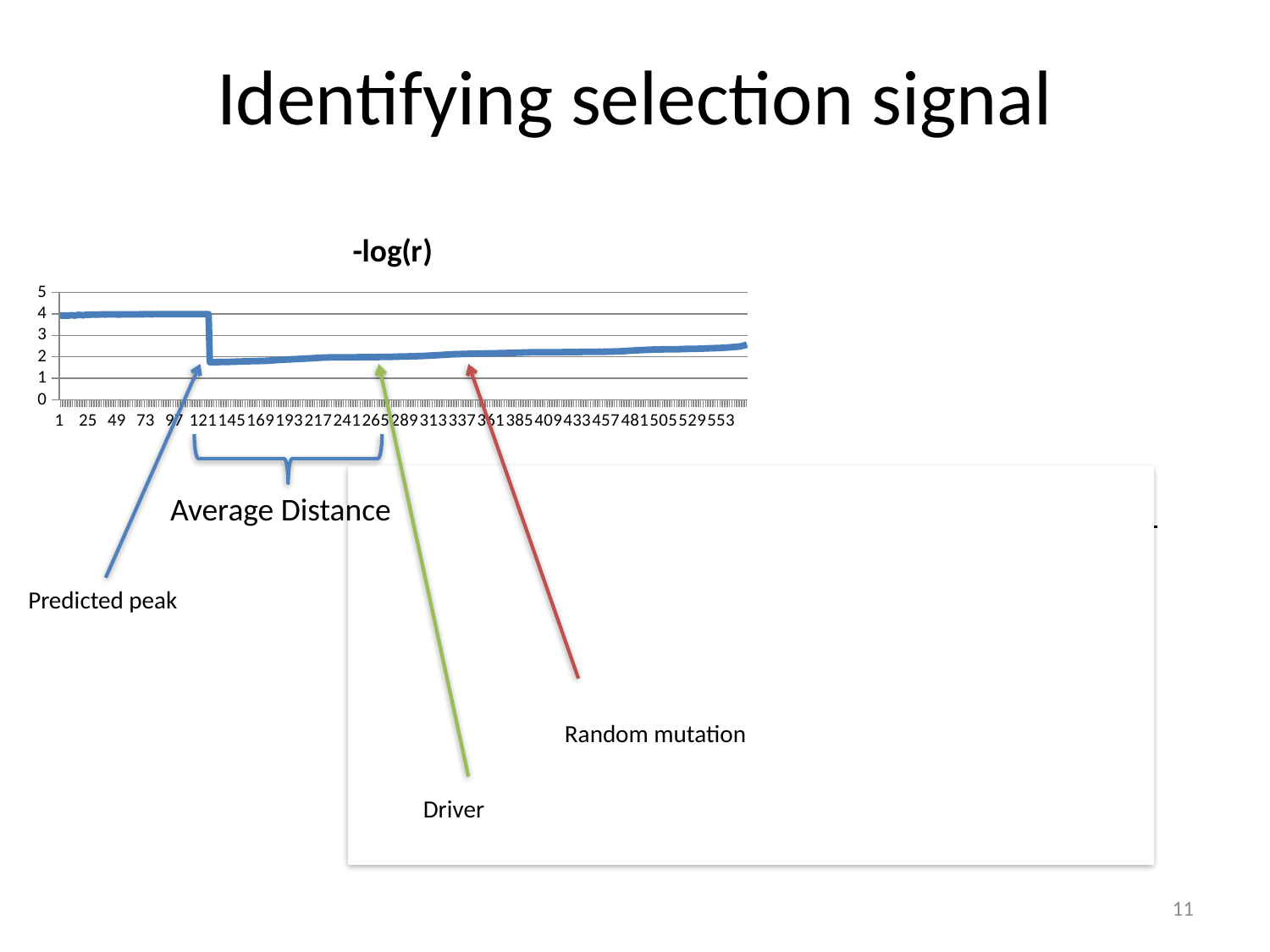
Does the line rise or fall sharply around x = 121? fall What kind of chart is shown on the slide? line chart Is the value of the line at x = 553 greater or less than 3? less What is the highest tick value shown on the y axis of the chart? 5 Which is larger, the value of the line at x = 25 or at x = 289? x = 25 Is the value of the line at x = 1 greater or less than 3? greater Is the value of the line at x = 145 greater or less than 1? greater After the sharp drop near x = 121, does the line rise or fall as x increases toward 553? rise Which is larger, the value of the line at x = 553 or at x = 145? x = 553 What is the title of the chart? -log(r)